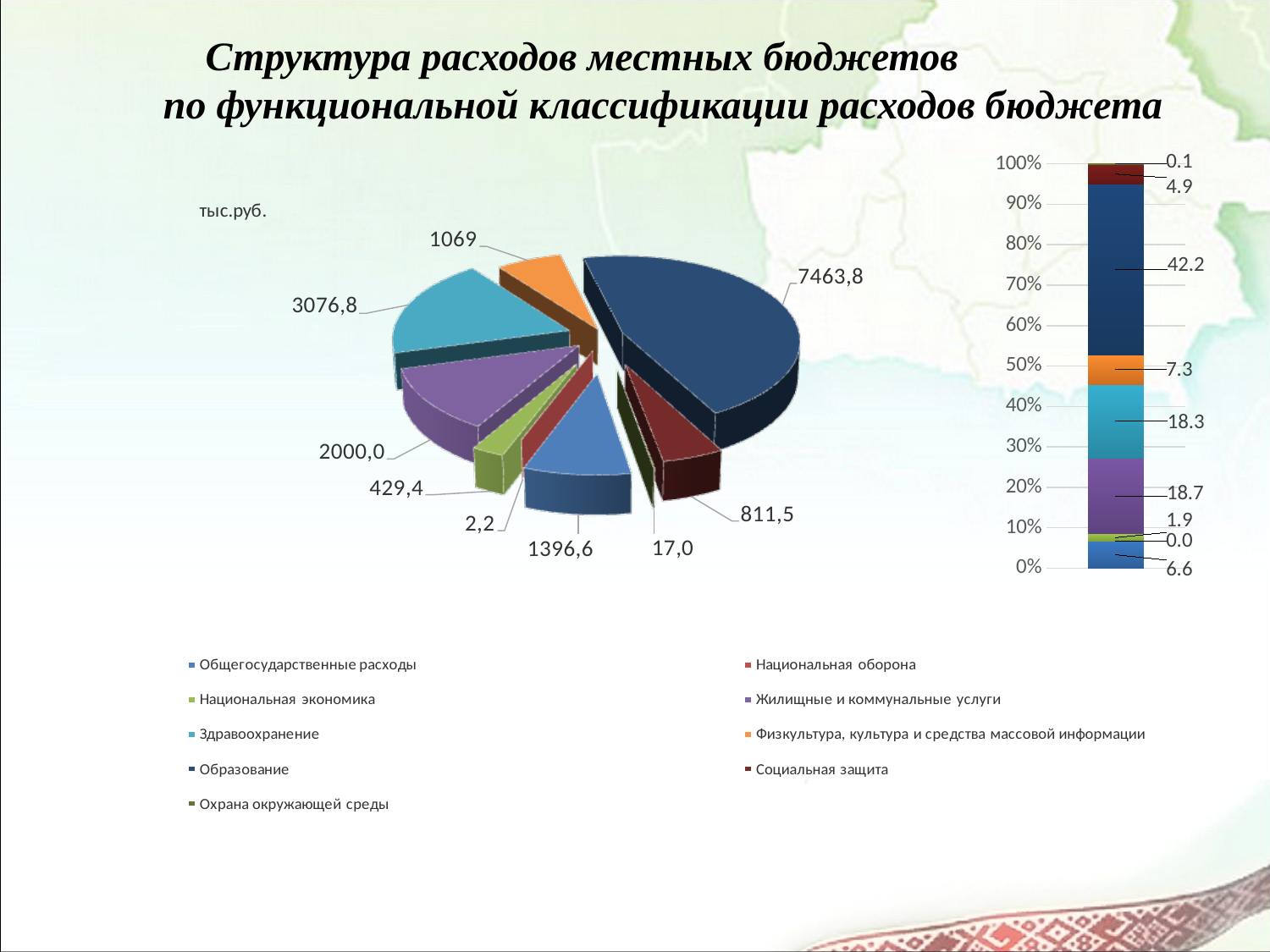
In the stacked bar chart on the right, what is the value of the purple segment (Жилищные и коммунальные услуги)? 18.7 In the stacked bar chart on the right, what is the value of the largest segment (Образование, dark navy)? 42.2 How many entries does the legend list? 9 In the pie chart on the left, what is the smallest value shown? 2,2 What type of chart is on the right side of the slide? stacked bar chart How many slices does the pie chart on the left have? 9 In the pie chart on the left, what is the value for Здравоохранение (the cyan slice)? 3076,8 What type of chart is on the left side of the slide? pie chart In the pie chart on the left, what is the difference between the cyan slice (3076,8) and the purple slice (2000,0)? 1076,8 In the pie chart on the left, what is the largest value shown? 7463,8 What unit label is shown above the pie chart on the left? тыс.руб. In the stacked bar chart on the right, which is larger: the cyan segment (18.3) or the orange segment (7.3)? the cyan segment (18.3)